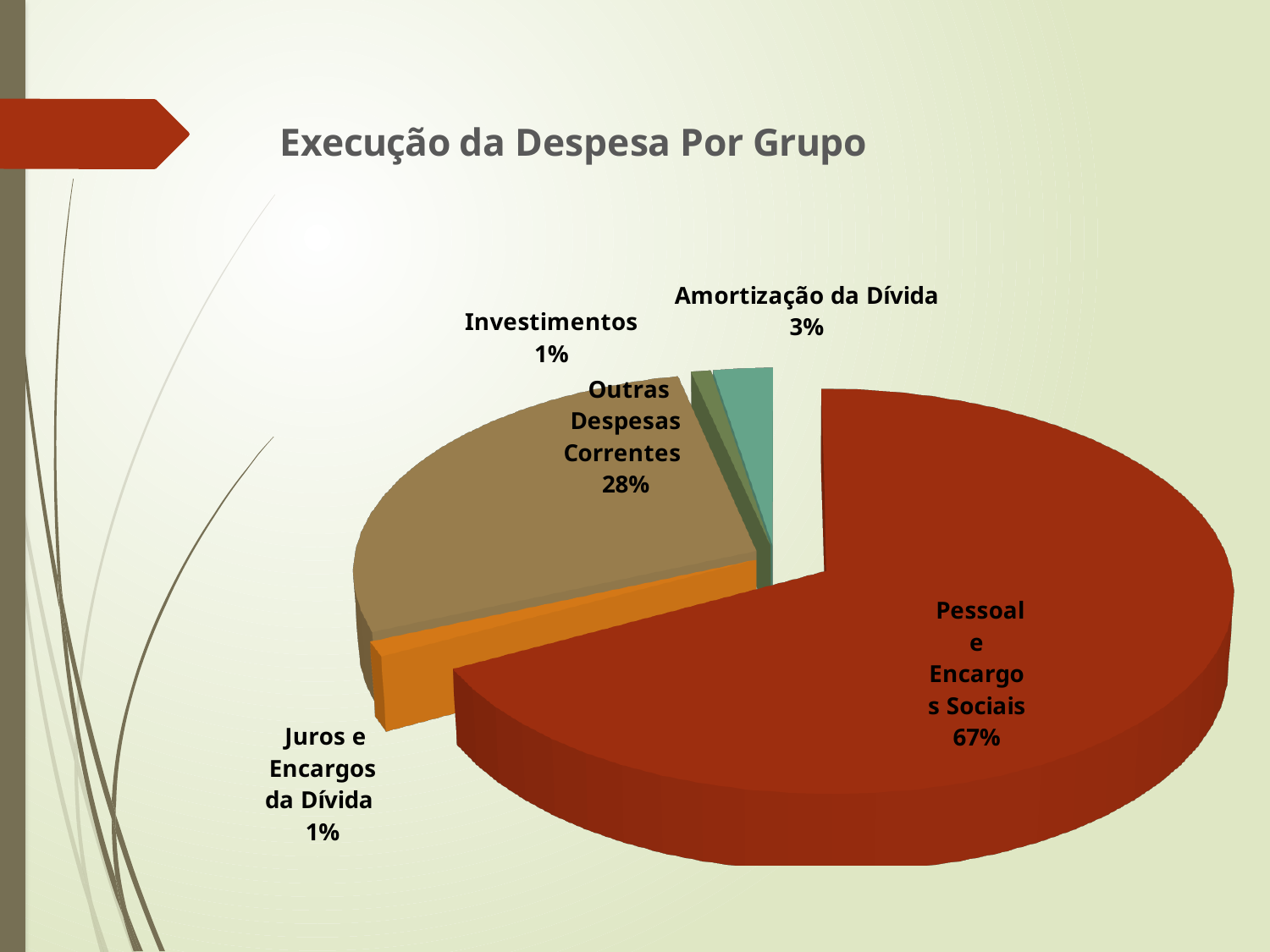
What colour is the slice for Pessoal e Encargos Sociais? Red What is the difference between the shares of Pessoal e Encargos Sociais and Outras Despesas Correntes? 39 percentage points What share of the pie does Pessoal e Encargos Sociais represent? 67% What is the value shown for Investimentos? 1% What share of the pie does Outras Despesas Correntes represent? 28% What is the value shown for Amortização da Dívida? 3% Which group has the largest slice of the pie? Pessoal e Encargos Sociais Which is larger, the share for Amortização da Dívida or the share for Investimentos? Amortização da Dívida What type of chart is shown on the slide? Pie chart How many slices does the pie chart have? 5 What is the value shown for Juros e Encargos da Dívida? 1% What is the title of the chart? Execução da Despesa Por Grupo